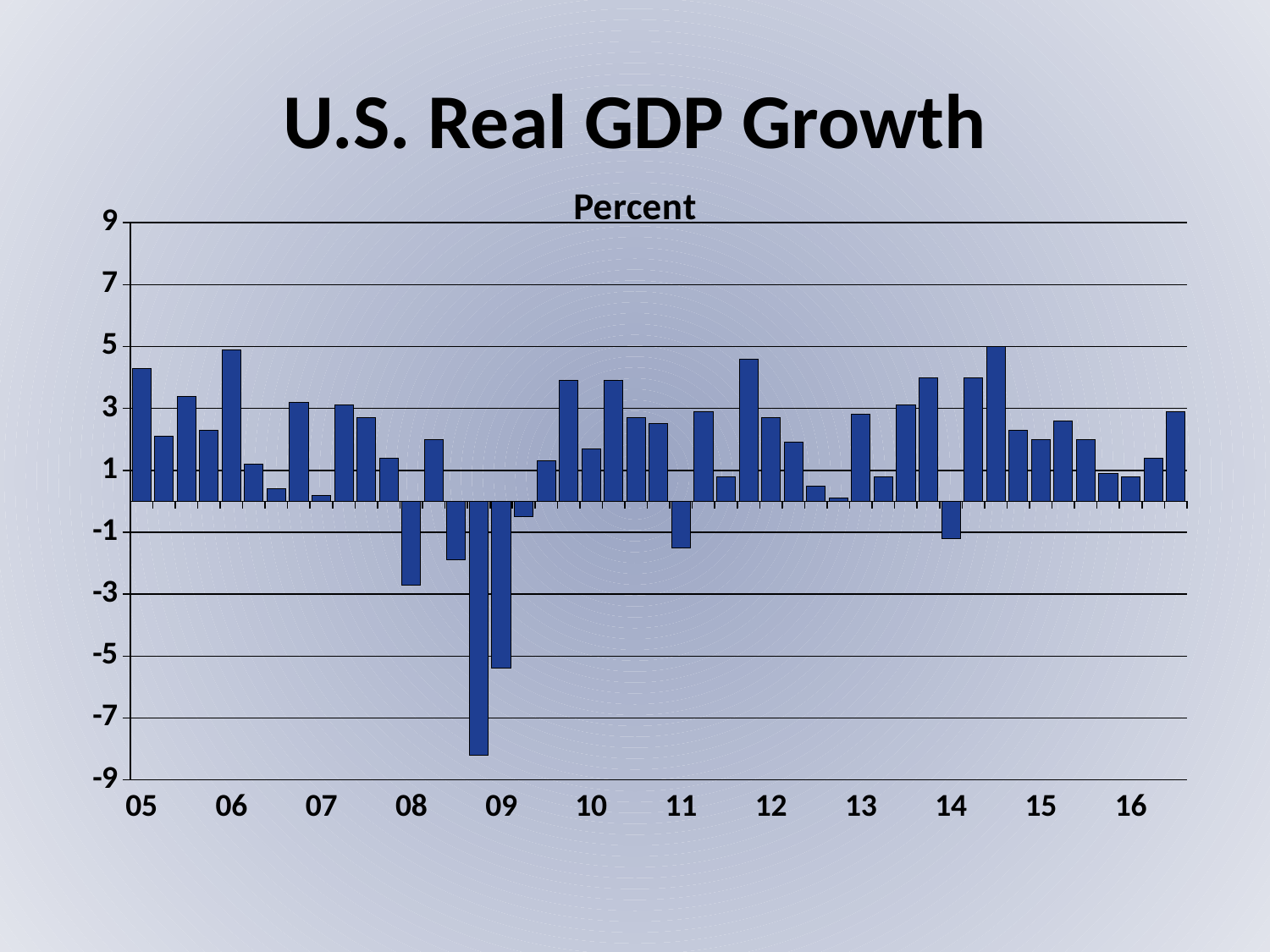
Is the value of the first bar at the 08 label greater or less than -1? less Around which year label does the lowest bar on the chart appear? 09 Is the value of the lowest bar on the chart greater or less than -7? less What kind of chart is shown on the slide? Bar chart Is the value of the tallest bar on the chart greater or less than 3? greater Which is larger, the first bar at the 05 label or the first bar at the 09 label? The first bar at 05 What is the title of the chart? U.S. Real GDP Growth What is the highest value shown on the vertical axis? 9 How many year labels are shown along the x axis? 12 What unit label is shown above the vertical axis? Percent